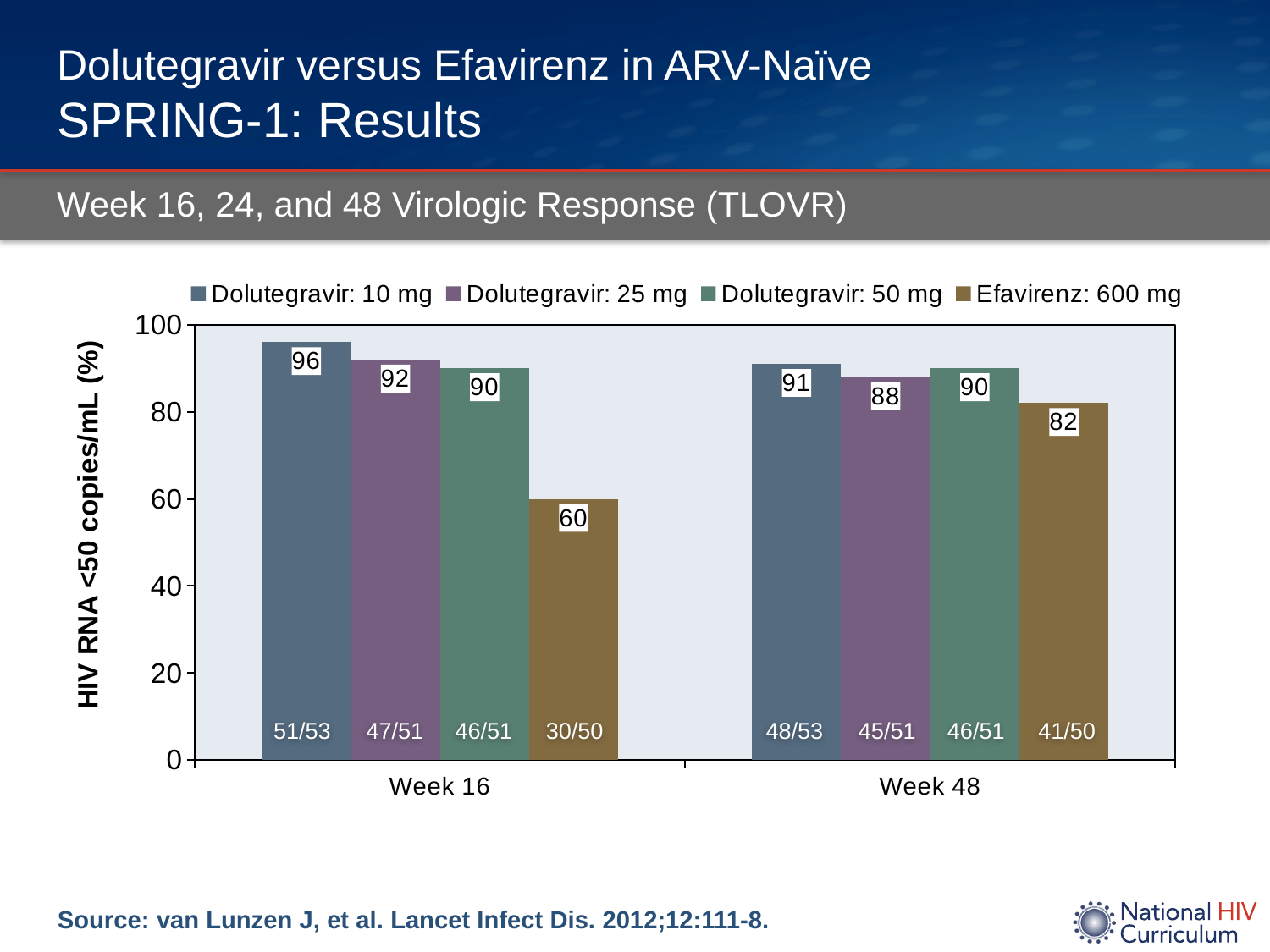
How many time-point categories are shown on the x axis? 2 What is the value for Dolutegravir: 25 mg at Week 48? 88 What is the value for Efavirenz: 600 mg at Week 48? 82 What is the y-axis label of the chart? HIV RNA <50 copies/mL (%) What is the value for Dolutegravir: 10 mg at Week 16? 96 Which series has the lowest value at Week 16? Efavirenz: 600 mg Which series has the highest value at Week 48? Dolutegravir: 10 mg Which is larger at Week 48: Dolutegravir: 50 mg or Dolutegravir: 25 mg? Dolutegravir: 50 mg What kind of chart is shown? Bar chart Is the value for Efavirenz: 600 mg at Week 16 greater or less than 80? less What is the difference between the Dolutegravir: 10 mg and Efavirenz: 600 mg values at Week 16? 36 How many series does the legend list? 4